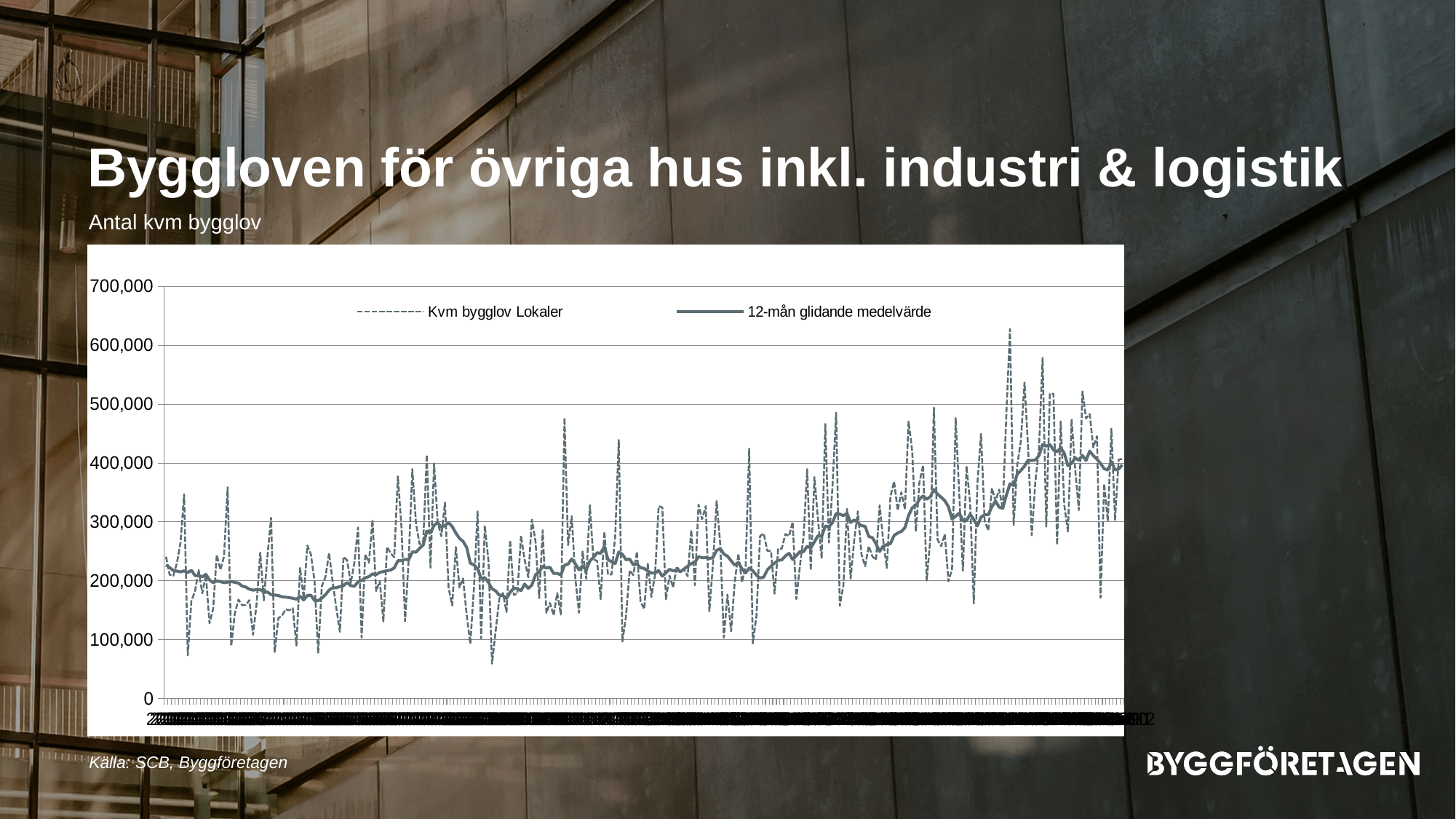
Which series is drawn with a dashed line? Kvm bygglov Lokaler Is the value of the 12-mån glidande medelvärde series at the right end of the chart greater or less than 300,000? greater Is the lowest point of the 12-mån glidande medelvärde series greater or less than 200,000? less Is the highest point of the 12-mån glidande medelvärde series greater or less than 400,000? greater What is the highest value shown on the y axis? 700,000 How many series does the chart legend list? 2 Does the 12-mån glidande medelvärde series end higher or lower than it starts? higher Does the 12-mån glidande medelvärde series generally rise or fall over the last third of the chart? rise What are the two series named in the chart legend? Kvm bygglov Lokaler; 12-mån glidande medelvärde What kind of chart is shown on the slide? line chart